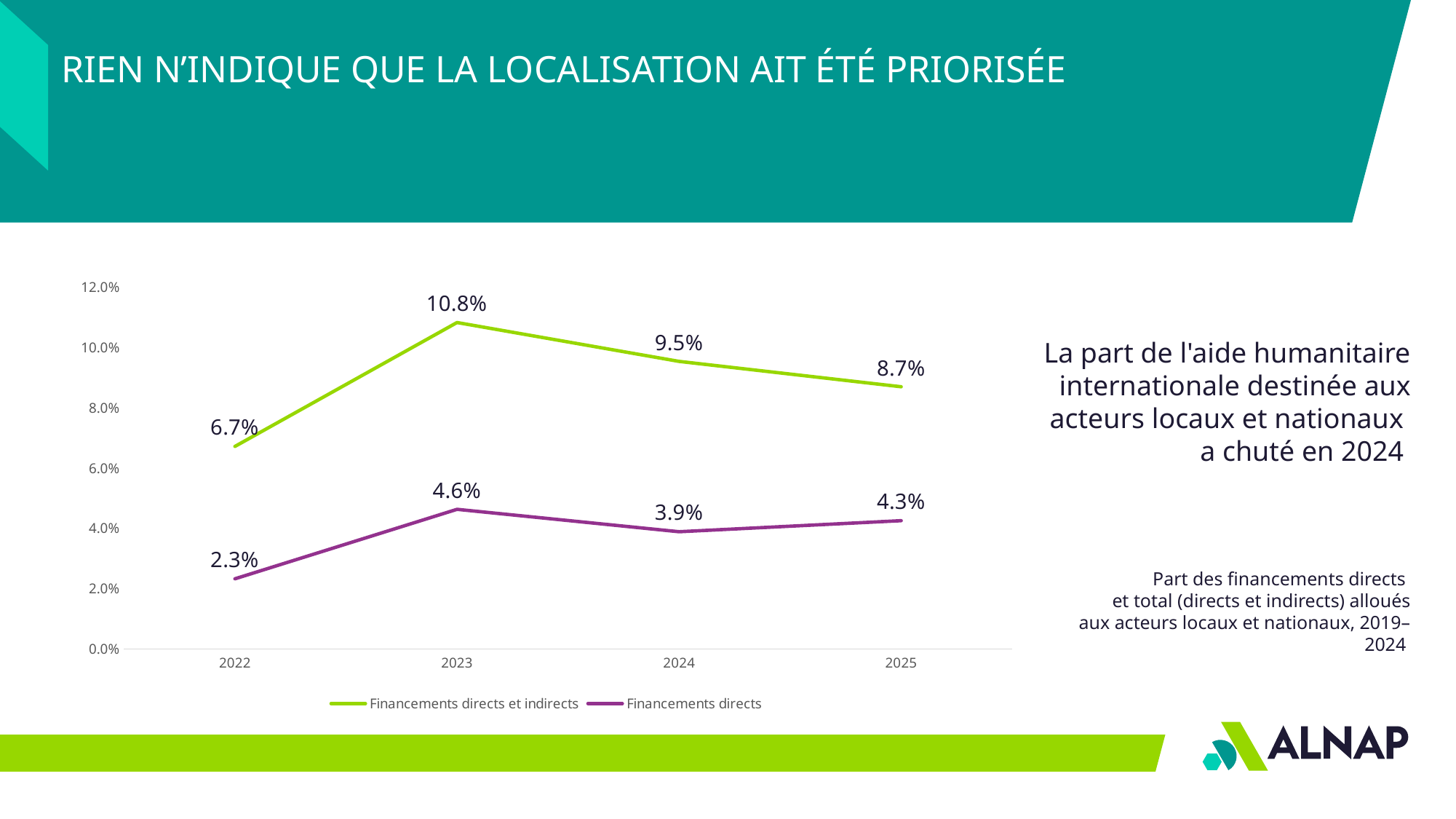
Which is larger: Financements directs in 2023 or Financements directs in 2025? Financements directs in 2023 What is the value for Financements directs in 2022? 2.3% How many series does the legend list? 2 In which year is Financements directs lowest? 2022 Does Financements directs et indirects rise or fall from 2023 to 2025? fall What type of chart is shown on the slide? line chart What colour is the line for Financements directs? purple What is the difference between Financements directs et indirects and Financements directs in 2024? 5.6% What is the value for Financements directs in 2025? 4.3% What is the value for Financements directs et indirects in 2023? 10.8% How many years are plotted on the x axis? 4 In which year is Financements directs et indirects highest? 2023